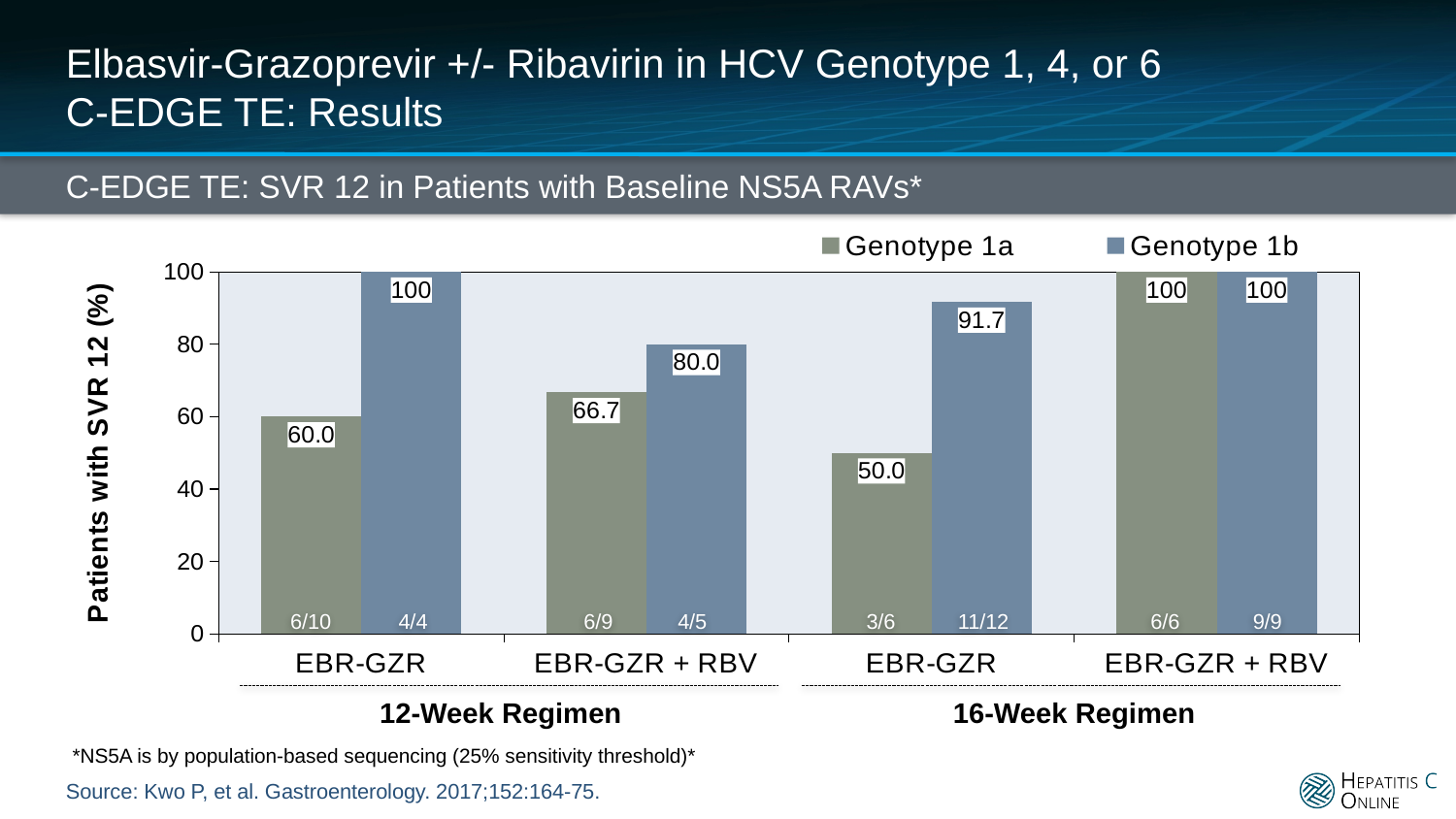
What kind of chart is shown on the slide? Bar chart What is the title of the chart? C-EDGE TE: SVR 12 in Patients with Baseline NS5A RAVs* How many treatment groups are shown on the x axis? 4 What is the SVR 12 rate for Genotype 1b in the EBR-GZR group of the 16-Week Regimen? 91.7 What is the label of the y axis? Patients with SVR 12 (%) What fraction of patients is shown for Genotype 1b in the EBR-GZR group of the 16-Week Regimen? 11/12 What is the SVR 12 rate for Genotype 1a in the EBR-GZR group of the 12-Week Regimen? 60.0 Which group has the lowest Genotype 1a SVR 12 rate? EBR-GZR, 16-Week Regimen In the EBR-GZR + RBV group of the 12-Week Regimen, which genotype has the higher SVR 12 rate? Genotype 1b How many series does the legend list? 2 What is the SVR 12 rate for Genotype 1b in the EBR-GZR + RBV group of the 12-Week Regimen? 80.0 What is the difference between the Genotype 1b and Genotype 1a SVR 12 rates in the EBR-GZR group of the 12-Week Regimen? 40.0